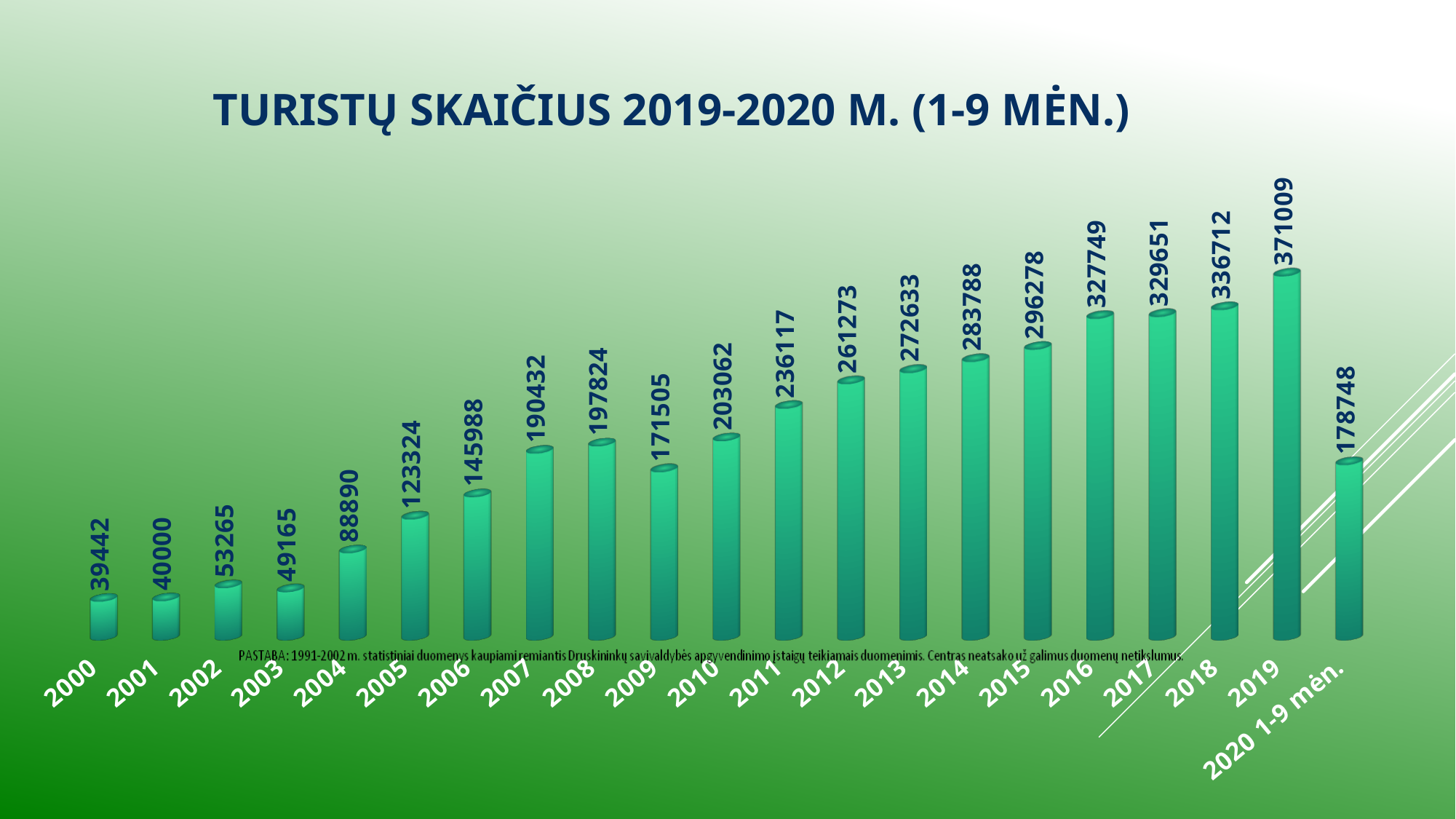
Which is larger, the value for 2002 or the value for 2003? 2002 What is the value for 2009? 171505 How many categories are shown on the x axis? 21 What kind of chart is this? bar chart Which year has the highest value? 2019 What is the value for 2005? 123324 What is the value for 2019? 371009 What is the title of the chart? TURISTŲ SKAIČIUS 2019-2020 M. (1-9 MĖN.) What is the value for 2020 1-9 mėn.? 178748 What is the difference between the values for 2008 and 2009? 26319 Which year has the lowest value? 2000 What is the difference between the values for 2019 and 2018? 34297